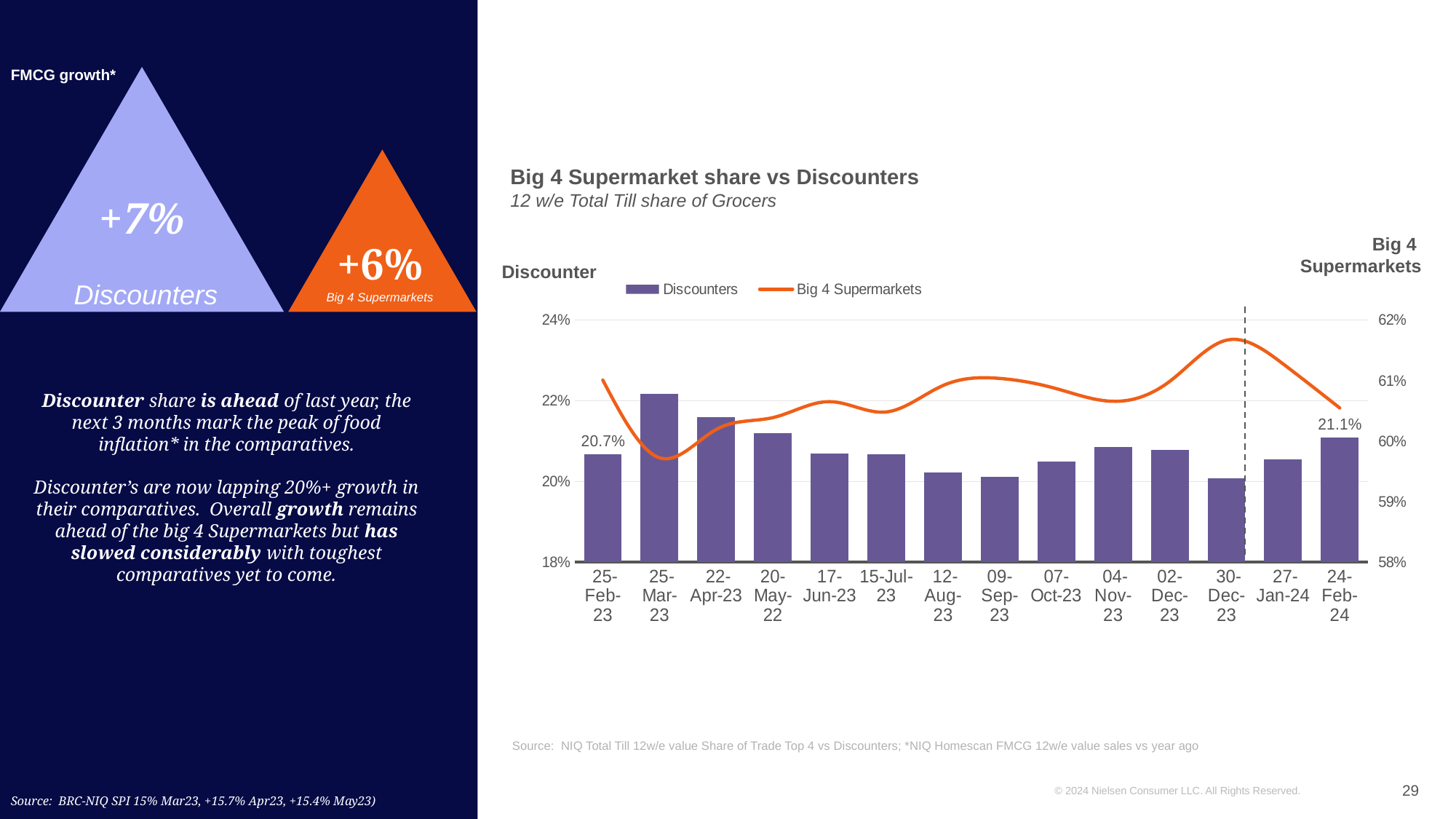
Which period has the highest Discounters bar? 25-Mar-23 How many time periods are shown on the x axis of the chart? 14 What is the Discounters share for 25-Feb-23? 20.7% Is the Discounters bar for 25-Mar-23 larger or smaller than the bar for 09-Sep-23? larger By how many percentage points did the Discounters share change between 25-Feb-23 and 24-Feb-24? 0.4 percentage points Is the Big 4 Supermarkets share at 30-Dec-23 greater or less than 61%? greater How many series does the chart legend list? 2 What is the Discounters share for 24-Feb-24? 21.1% Which series is plotted as a line rather than bars? Big 4 Supermarkets Is the Discounters share for 20-May-22 greater or less than 22%? less Is the Discounters share for 04-Nov-23 greater or less than 20%? greater Does the Big 4 Supermarkets line rise or fall between 30-Dec-23 and 24-Feb-24? fall